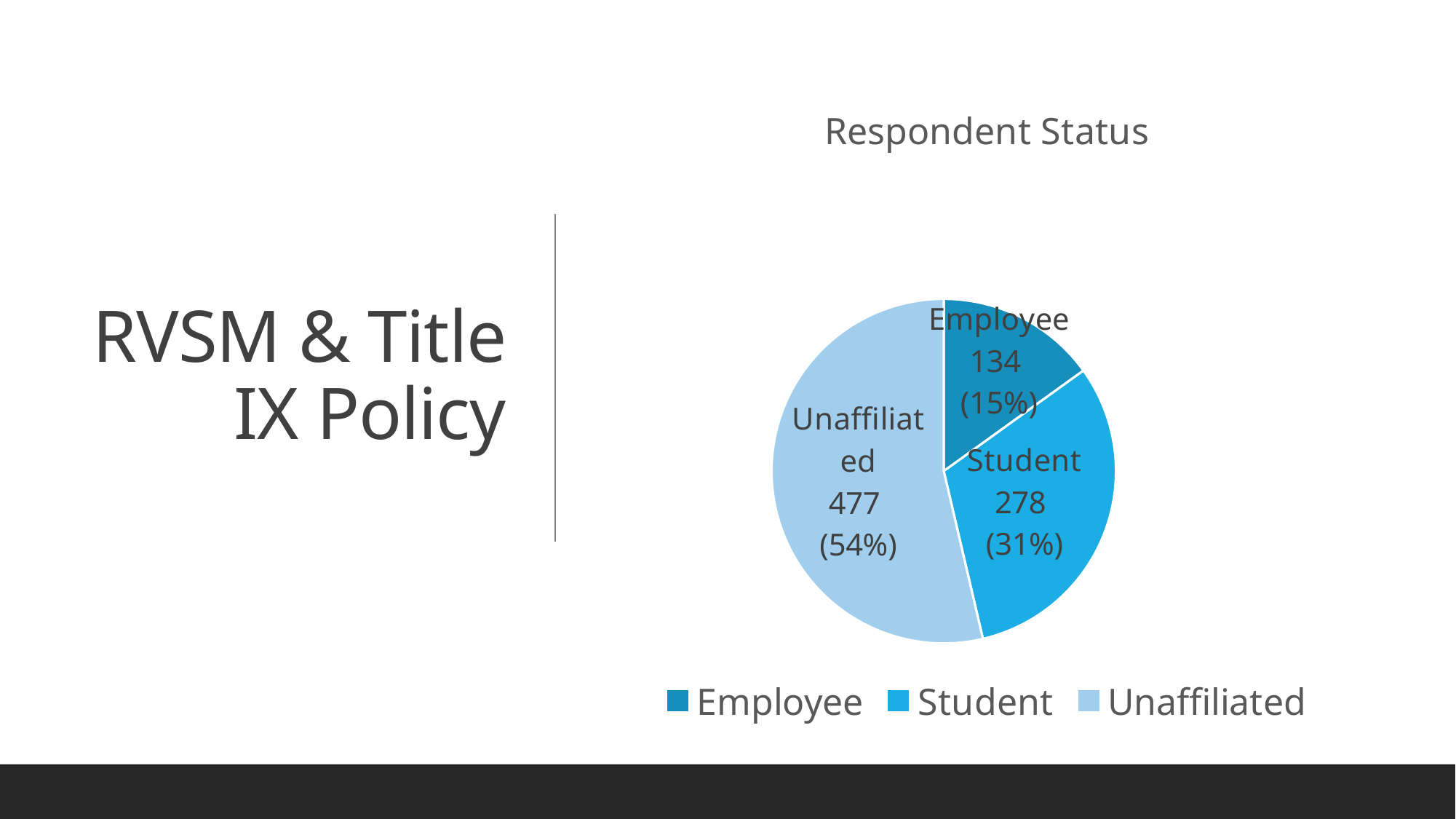
Which is larger in the Respondent Status chart, Student or Employee? Student What is the value for Student in the Respondent Status pie chart? 278 What is the value for Employee in the Respondent Status pie chart? 134 What share of the pie does Unaffiliated represent in the Respondent Status chart? 54% What is the difference between the Unaffiliated and Student values in the Respondent Status chart? 199 How many categories are shown in the Respondent Status pie chart? 3 What is the value for Unaffiliated in the Respondent Status pie chart? 477 Which category has the smallest slice in the Respondent Status pie chart? Employee Which category has the largest slice in the Respondent Status pie chart? Unaffiliated What is the difference between the Student and Employee values in the Respondent Status chart? 144 What share of the pie does Employee represent in the Respondent Status chart? 15% What type of chart is used to show Respondent Status? Pie chart